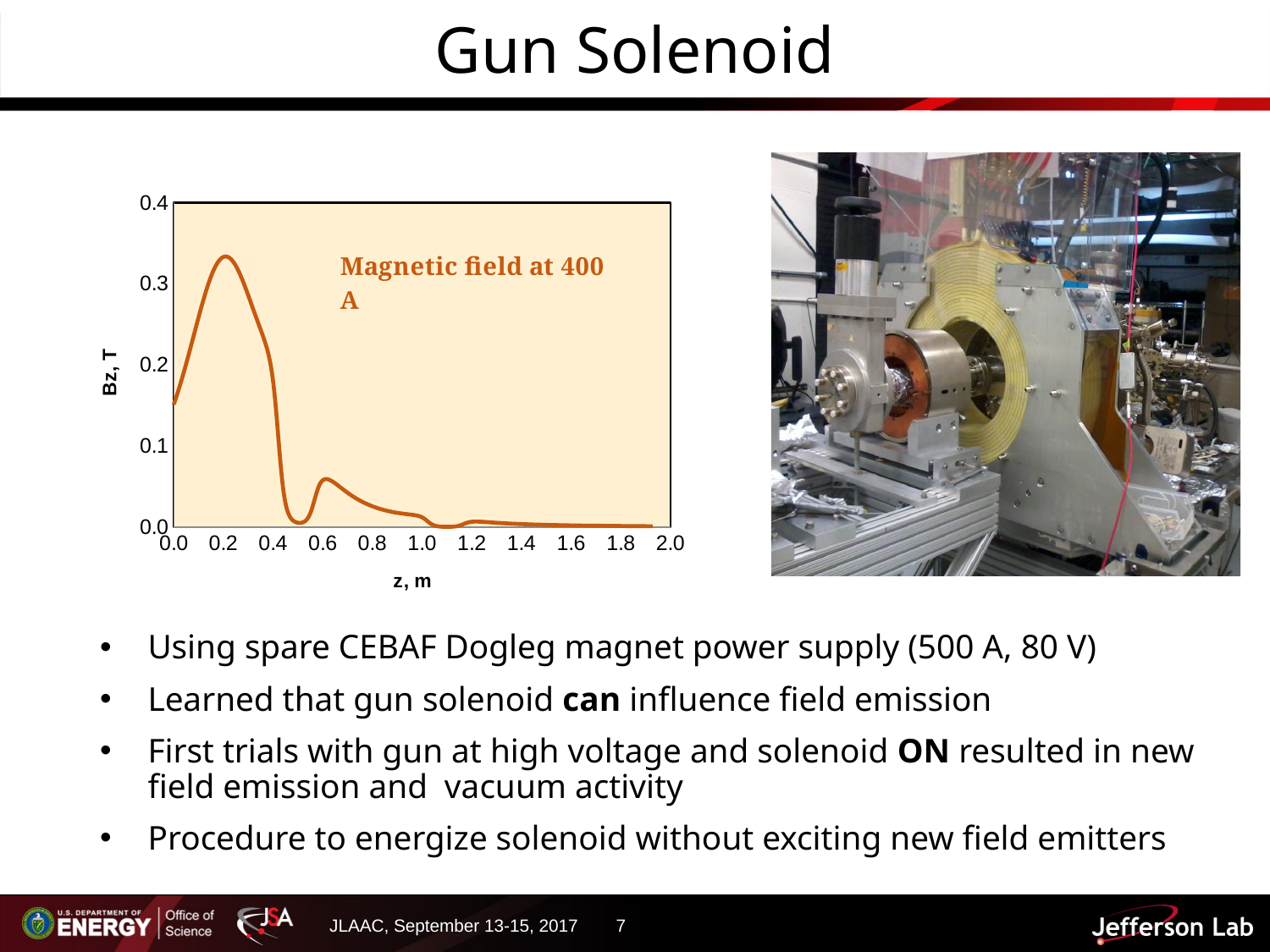
What is the label of the y axis of the chart? Bz, T Is the peak value of Bz on the chart greater or less than 0.3? greater Is the value of Bz at z = 0.0 m greater or less than 0.2? less Between z = 0.0 m and z = 0.2 m, does the value of Bz rise or fall? rise Between z = 0.2 m and z = 0.5 m, does the value of Bz rise or fall? fall Is the value of Bz at z = 1.5 m greater or less than 0.1? less What kind of chart is shown on the slide? line chart Which is larger, the value of Bz at z = 0.2 m or at z = 0.6 m? z = 0.2 m What is the highest tick value shown on the y axis of the chart? 0.4 What is the label of the x axis of the chart? z, m